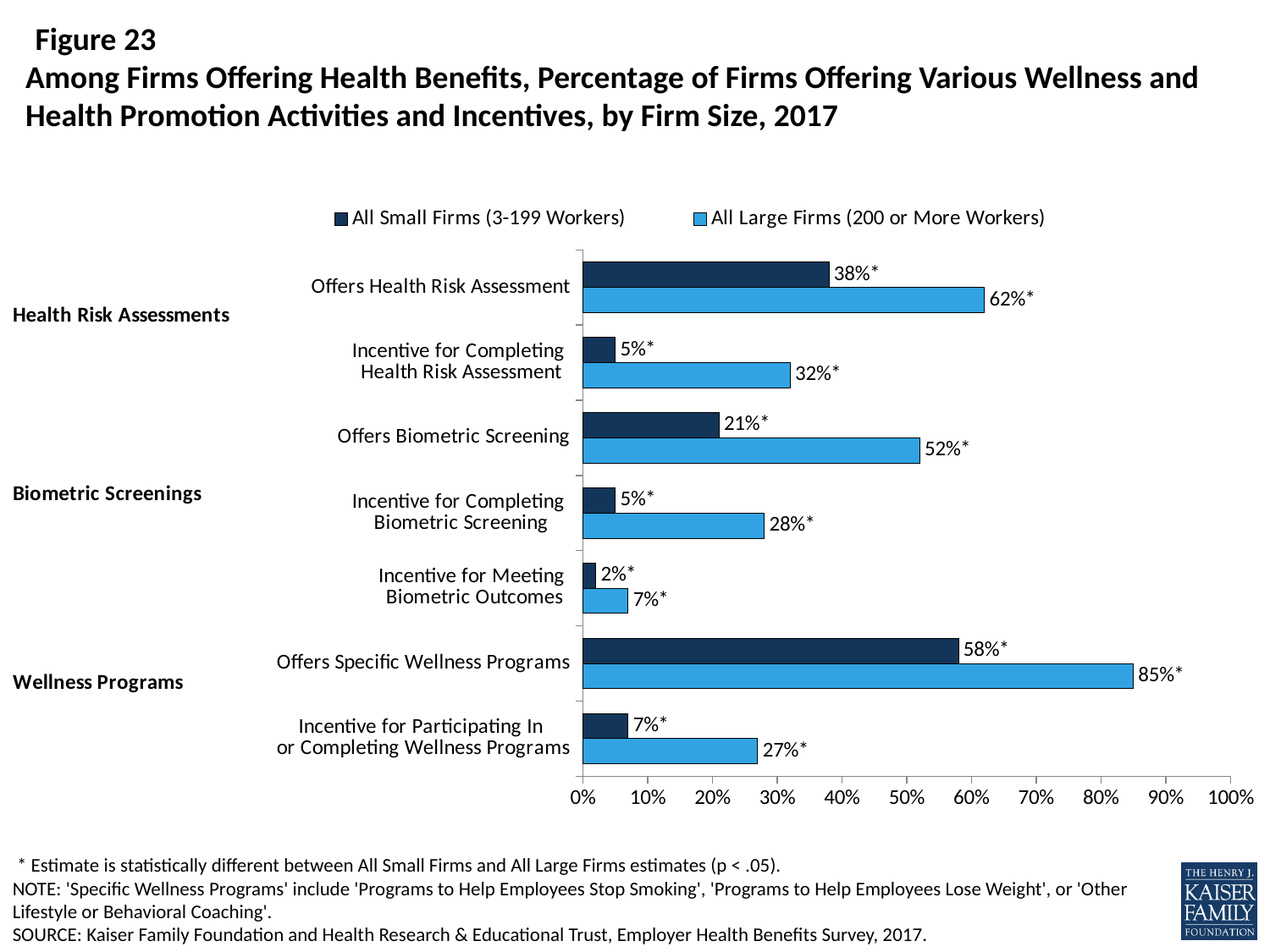
What is the difference between All Large Firms and All Small Firms for Offers Specific Wellness Programs? 27% What kind of chart is shown on the slide? Bar chart Which is larger for Incentive for Completing Health Risk Assessment: All Small Firms or All Large Firms? All Large Firms (200 or More Workers) Which category has the lowest value for All Small Firms (3-199 Workers)? Incentive for Meeting Biometric Outcomes How many series does the legend list? 2 What percentage of All Small Firms (3-199 Workers) offer an Incentive for Meeting Biometric Outcomes? 2% What percentage of All Large Firms (200 or More Workers) offer a Health Risk Assessment? 62% What is the difference between All Large Firms and All Small Firms for Offers Biometric Screening? 31% Which category has the highest value for All Large Firms (200 or More Workers)? Offers Specific Wellness Programs Which colour represents All Large Firms (200 or More Workers) in the chart? Light blue How many categories are shown on the chart? 7 What percentage of All Small Firms (3-199 Workers) offer Specific Wellness Programs? 58%